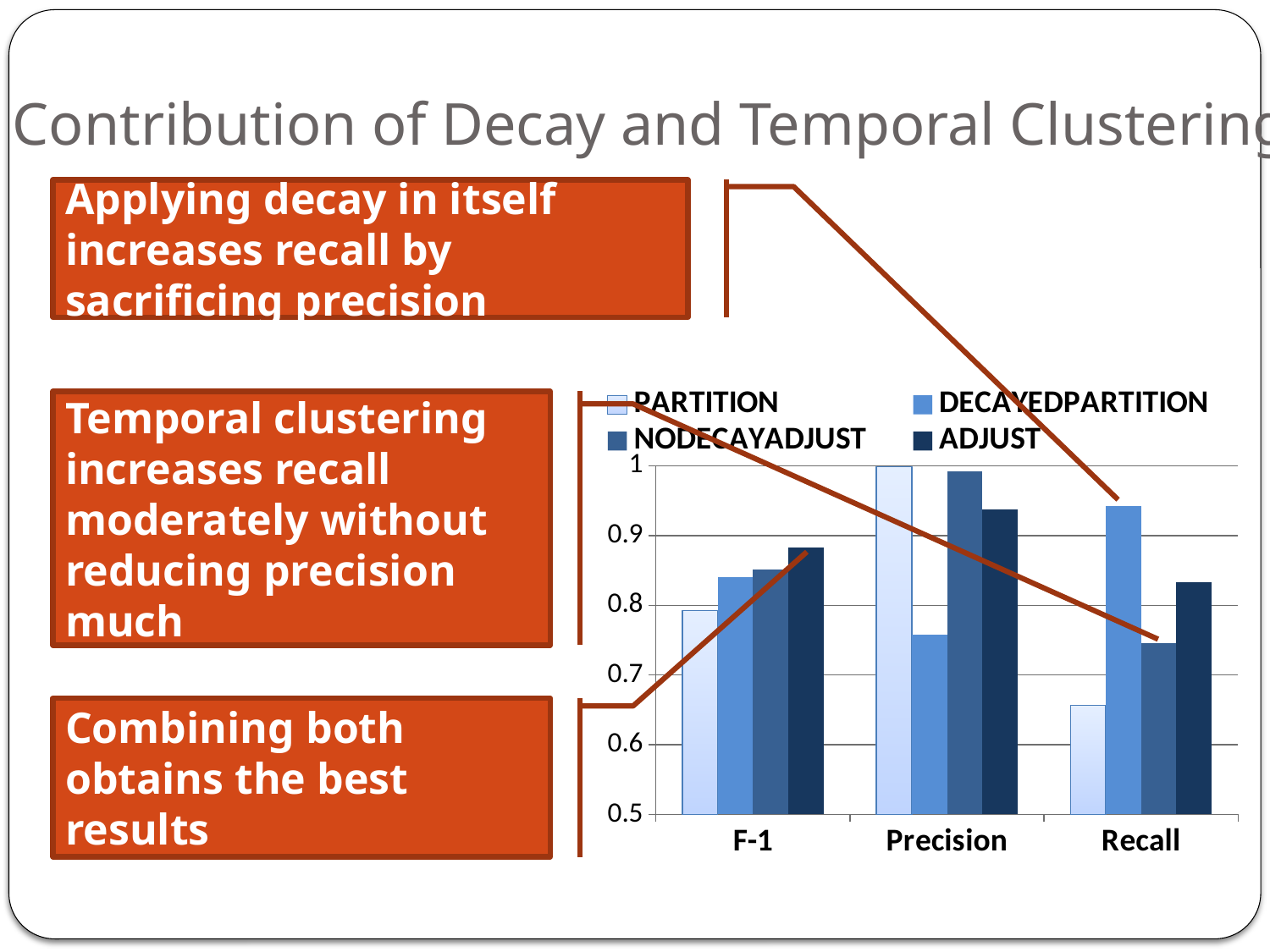
How many series does the chart's legend list? 4 How many categories are shown on the x axis of the chart? 3 Is the Recall value for PARTITION greater or less than 0.7? less Which series has the lowest Precision value? DECAYEDPARTITION What kind of chart is shown on the slide? bar chart Is the Recall value for DECAYEDPARTITION greater or less than 0.9? greater Which series is shown in the lightest blue in the chart's legend? PARTITION Which series has the highest Precision value? PARTITION Which series has the highest Recall value? DECAYEDPARTITION For F-1, which is larger: the PARTITION value or the ADJUST value? ADJUST Is the Precision value for DECAYEDPARTITION greater or less than 0.9? less Which series has the lowest Recall value? PARTITION